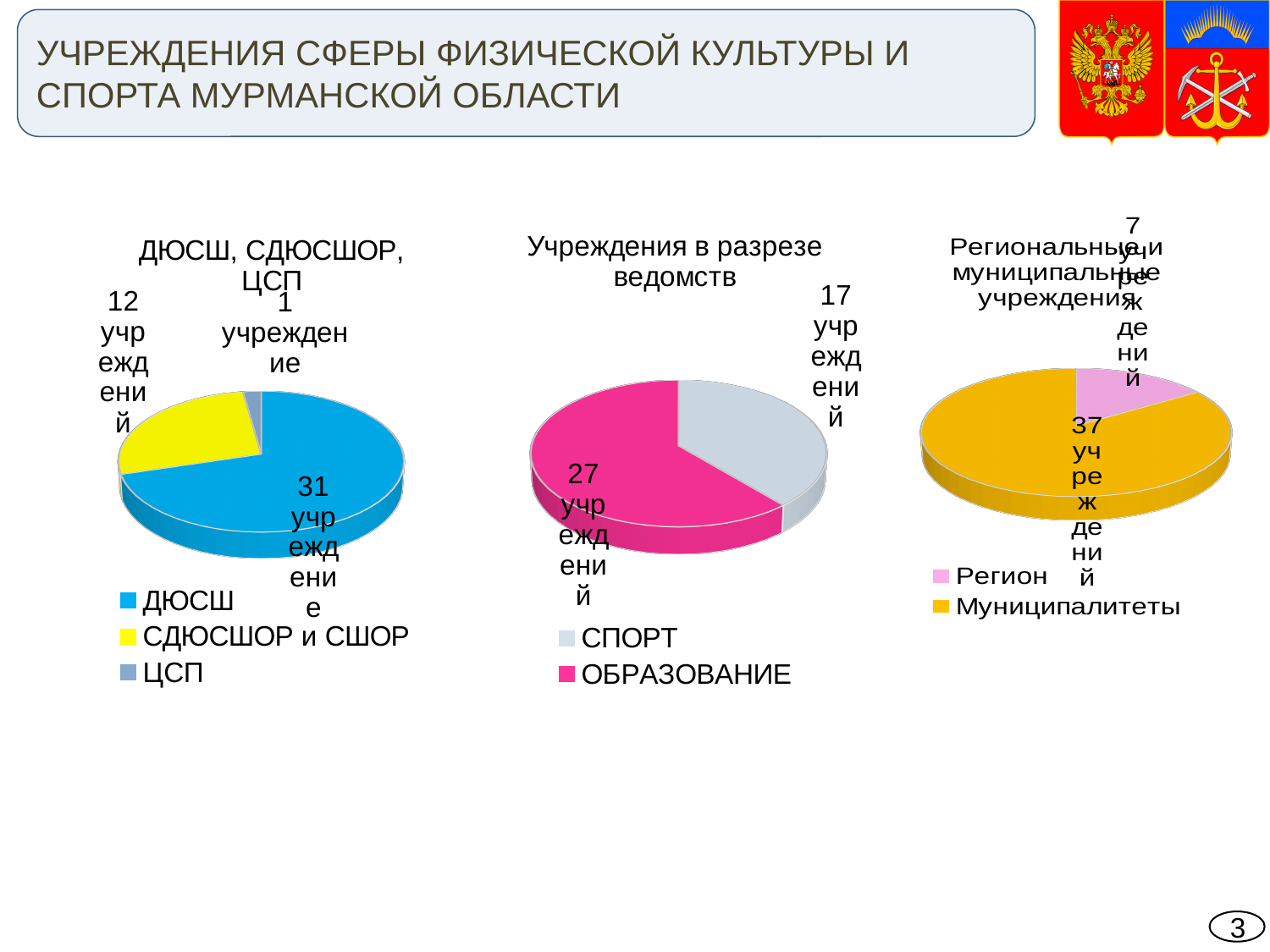
In the chart titled 'ДЮСШ, СДЮСШОР, ЦСП', how many institutions are labelled for ЦСП? 1 учреждение In the chart titled 'ДЮСШ, СДЮСШОР, ЦСП', how many institutions are labelled for ДЮСШ? 31 учреждение What type of chart is the chart titled 'Учреждения в разрезе ведомств'? Pie chart In the chart titled 'Учреждения в разрезе ведомств', how many institutions are labelled for ОБРАЗОВАНИЕ? 27 учреждений In the chart titled 'Учреждения в разрезе ведомств', what is the total of the two slices? 44 In the chart titled 'ДЮСШ, СДЮСШОР, ЦСП', what is the difference between the ДЮСШ value and the СДЮСШОР и СШОР value? 19 In the chart titled 'ДЮСШ, СДЮСШОР, ЦСП', which category has the largest slice? ДЮСШ In the chart titled 'Региональные и муниципальные учреждения', what is the difference between Муниципалитеты and Регион? 30 In the chart titled 'Региональные и муниципальные учреждения', how many institutions are labelled for Муниципалитеты? 37 учреждений In the chart titled 'ДЮСШ, СДЮСШОР, ЦСП', how many categories does the legend list? 3 In the chart titled 'Учреждения в разрезе ведомств', which is larger, СПОРТ or ОБРАЗОВАНИЕ? ОБРАЗОВАНИЕ In the chart titled 'ДЮСШ, СДЮСШОР, ЦСП', which category has the smallest slice? ЦСП